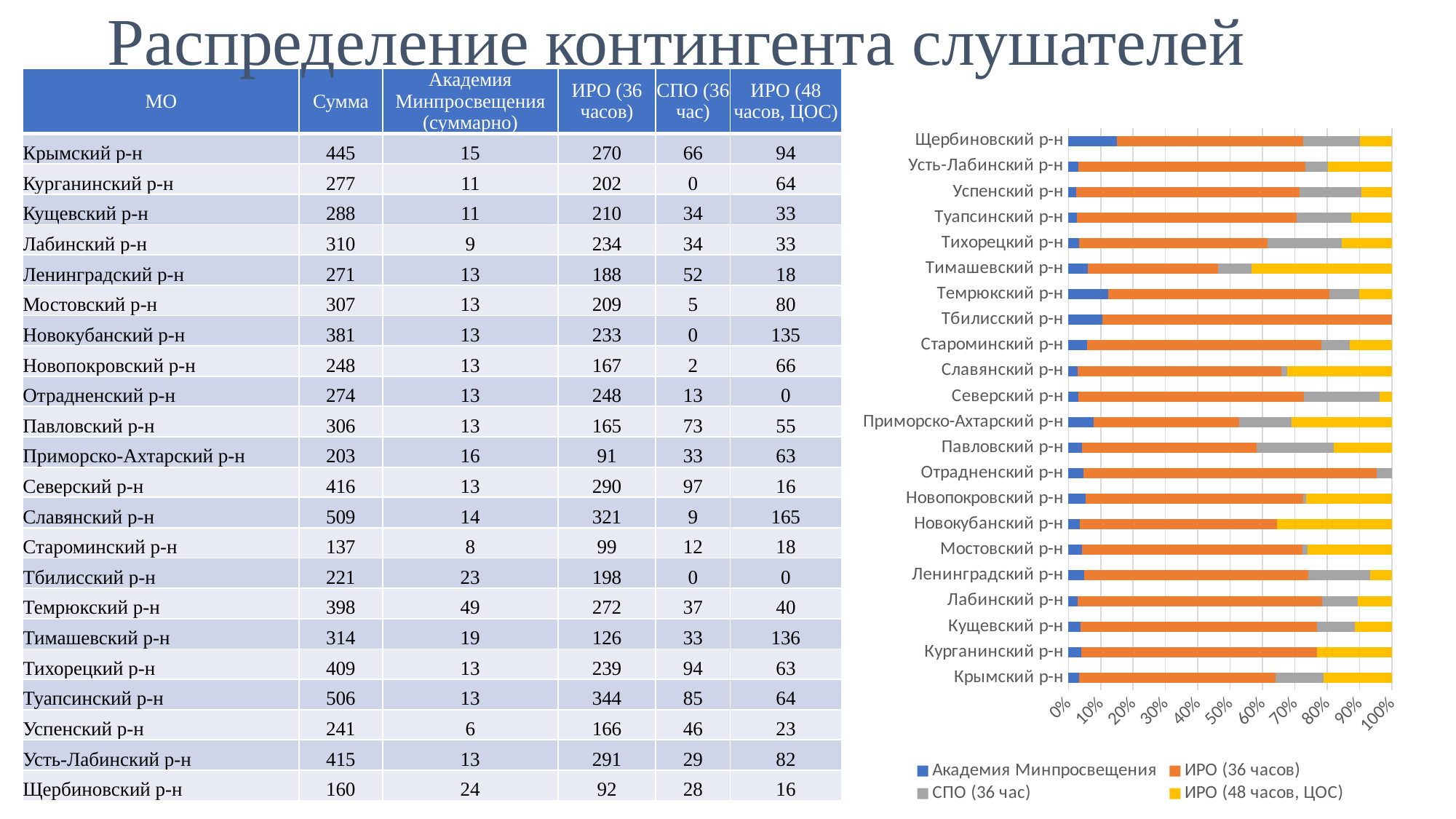
How many districts (categories) are plotted in the bar chart? 22 What kind of chart is shown on the right side of the slide? 100% stacked bar chart In the bar chart, is the share of ИРО (48 часов, ЦОС) for Новокубанский р-н greater or less than 20%? greater According to the table on the slide, what is the Сумма value for Славянский р-н? 509 What colour represents СПО (36 час) in the chart legend? Grey In the bar chart, which has the larger share of ИРО (48 часов, ЦОС): Тимашевский р-н or Крымский р-н? Тимашевский р-н In the bar chart, is the share of Академия Минпросвещения for Темрюкский р-н greater or less than 20%? less How many series does the chart legend list? 4 In the bar chart, which district's bar has no yellow (ИРО 48 часов, ЦОС) segment at all? Тбилисский р-н and Отрадненский р-н In the bar chart, is the share of ИРО (36 часов) for Тбилисский р-н greater or less than 80%? greater In the bar chart, which district has the largest share for Академия Минпросвещения (blue segment)? Щербиновский р-н In the bar chart, which district has the largest share for ИРО (48 часов, ЦОС) (yellow segment)? Тимашевский р-н